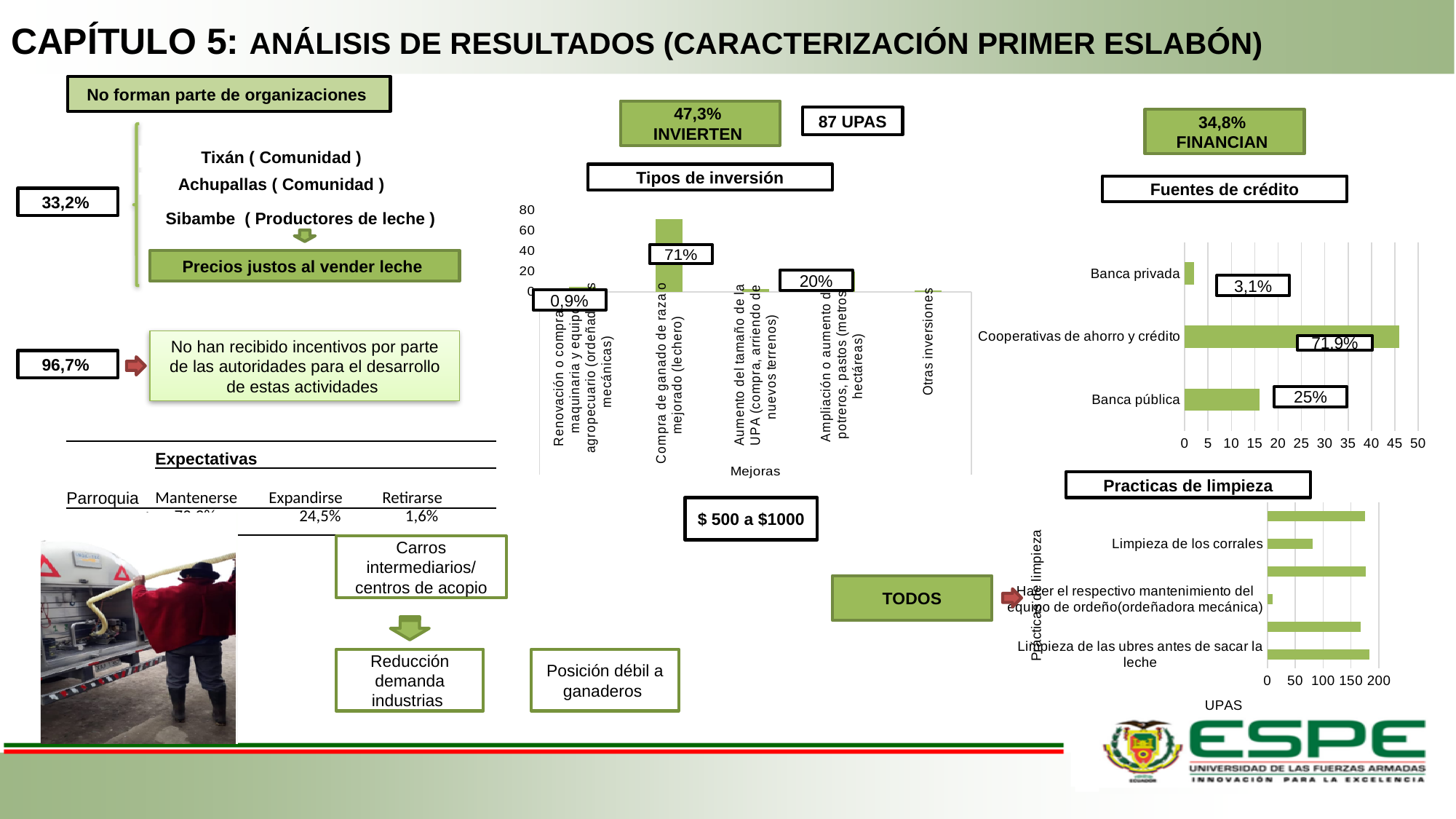
In the 'Tipos de inversión' chart, which category has the highest value? Compra de ganado de raza o mejorado (lechero) In the 'Fuentes de crédito' chart, what is the value for 'Banca privada'? 3,1% What type of chart is the 'Tipos de inversión' chart? bar chart What is the horizontal axis title of the 'Practicas de limpieza' chart? UPAS In the 'Fuentes de crédito' chart, what is the difference between 'Cooperativas de ahorro y crédito' and 'Banca pública'? 46,9% In the 'Tipos de inversión' chart, how many categories are shown on the x axis? 5 In the 'Practicas de limpieza' chart, is the bar for 'Limpieza de las ubres antes de sacar la leche' greater or less than 150? greater In the 'Fuentes de crédito' chart, which source has the lowest value? Banca privada In the 'Fuentes de crédito' chart, what is the value for 'Cooperativas de ahorro y crédito'? 71,9% In the 'Practicas de limpieza' chart, which is larger: 'Limpieza de las ubres antes de sacar la leche' or 'Limpieza de los corrales'? Limpieza de las ubres antes de sacar la leche In the 'Tipos de inversión' chart, is the bar for 'Compra de ganado de raza o mejorado (lechero)' greater or less than 60? greater In the 'Tipos de inversión' chart, what is the value for 'Compra de ganado de raza o mejorado (lechero)'? 71%